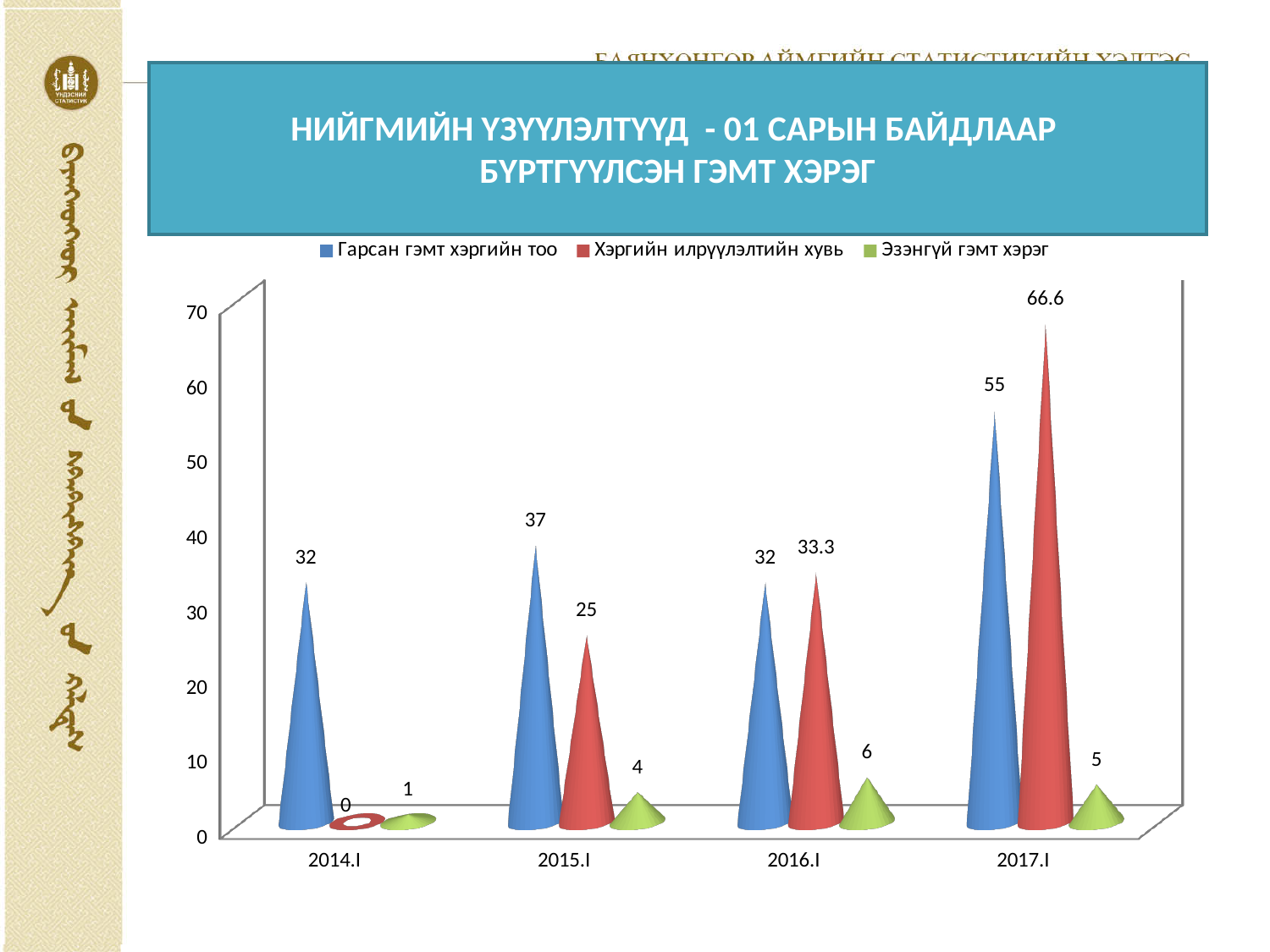
How many years are shown on the x axis? 4 What is the value of Хэргийн илрүүлэлтийн хувь for 2016.I? 33.3 Which is larger in 2016.I: Гарсан гэмт хэргийн тоо or Хэргийн илрүүлэлтийн хувь? Хэргийн илрүүлэлтийн хувь What kind of chart is shown on the slide? Bar chart Which colour represents Эзэнгүй гэмт хэрэг in the legend? Green What is the difference between Гарсан гэмт хэргийн тоо in 2017.I and in 2015.I? 18 How many series does the legend list? 3 What is the value of Эзэнгүй гэмт хэрэг for 2015.I? 4 What is the value of Хэргийн илрүүлэлтийн хувь for 2014.I? 0 What is the value of Гарсан гэмт хэргийн тоо for 2017.I? 55 In which year is Эзэнгүй гэмт хэрэг lowest? 2014.I In which year is Хэргийн илрүүлэлтийн хувь highest? 2017.I